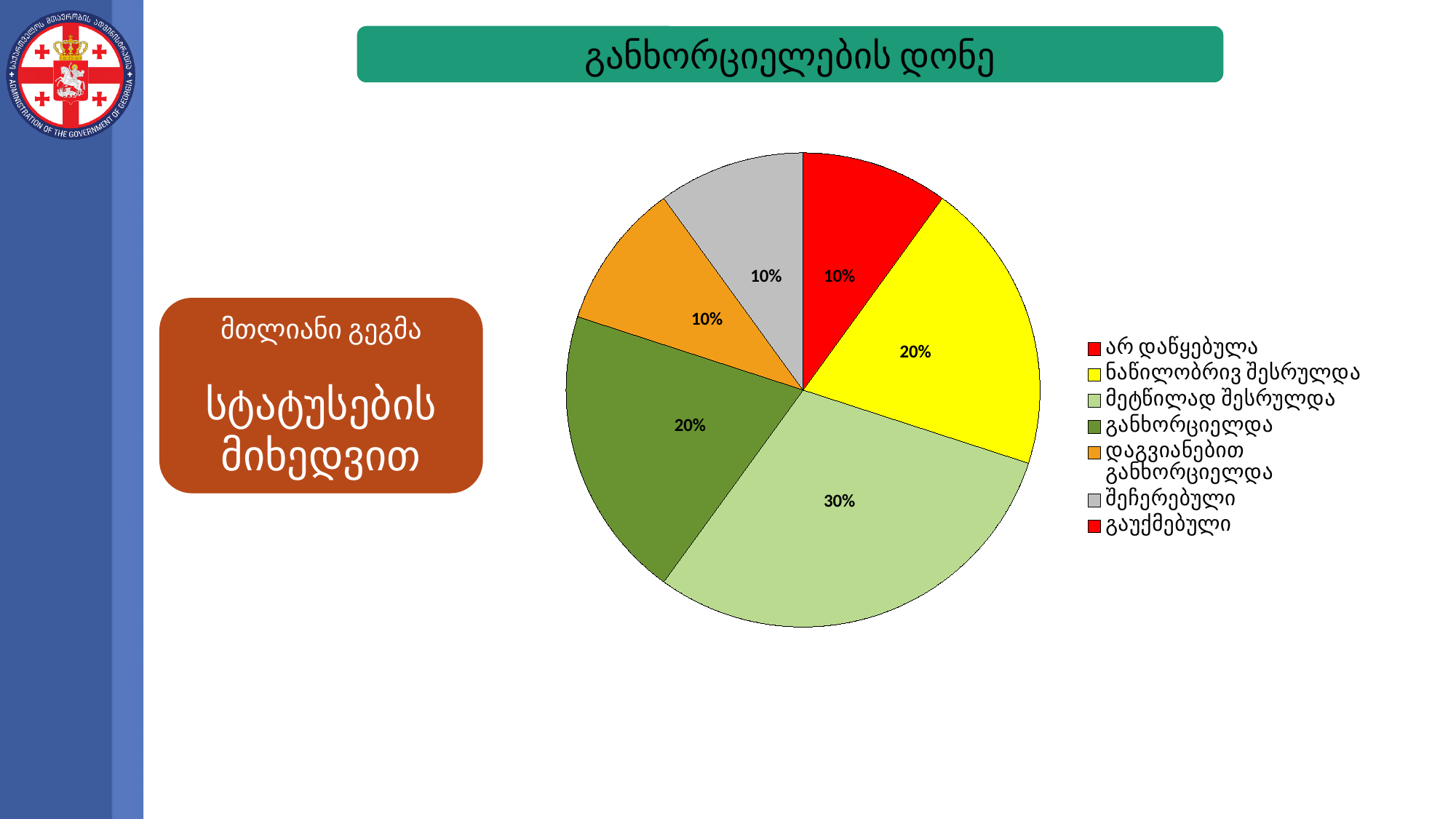
Which category has the largest slice of the pie? მეტწილად შესრულდა What is the value shown for განხორციელდა? 20% How many slices are visible in the pie chart? 6 How many entries does the legend list? 7 What is the difference between the value for მეტწილად შესრულდა and the value for არ დაწყებულა? 20% What kind of chart is shown on the slide? pie chart What is the value shown for ნაწილობრივ შესრულდა? 20% What share of the pie does მეტწილად შესრულდა take? 30% What is the value shown for დაგვიანებით განხორციელდა? 10% What is the value shown for შეჩერებული? 10% Which is larger, the slice for მეტწილად შესრულდა or the slice for განხორციელდა? მეტწილად შესრულდა What is the title shown above the chart? განხორციელების დონე